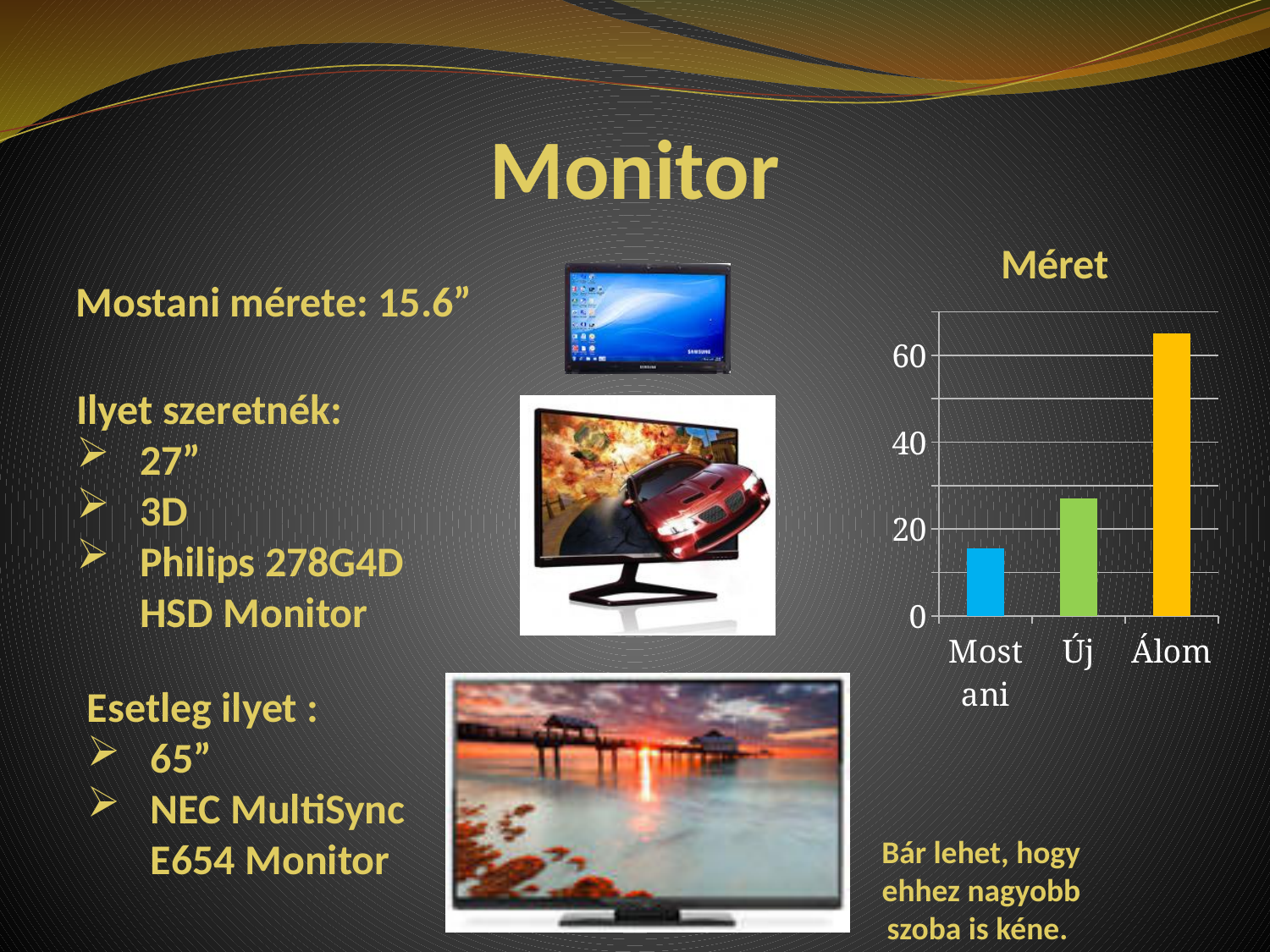
Which category has the lowest bar in the Méret chart? Mostani How many bars does the Méret chart have? 3 Which is larger in the Méret chart, Új or Mostani? Új Is the value for Mostani greater or less than 20? less Which category has the highest bar in the Méret chart? Álom Is the value for Álom greater or less than 60? greater Is the value for Új greater or less than 40? less What colour is the Álom bar in the Méret chart? yellow Do the bar values rise or fall from left to right in the Méret chart? rise What kind of chart is shown on the slide? bar chart What is the title of the chart on the slide? Méret